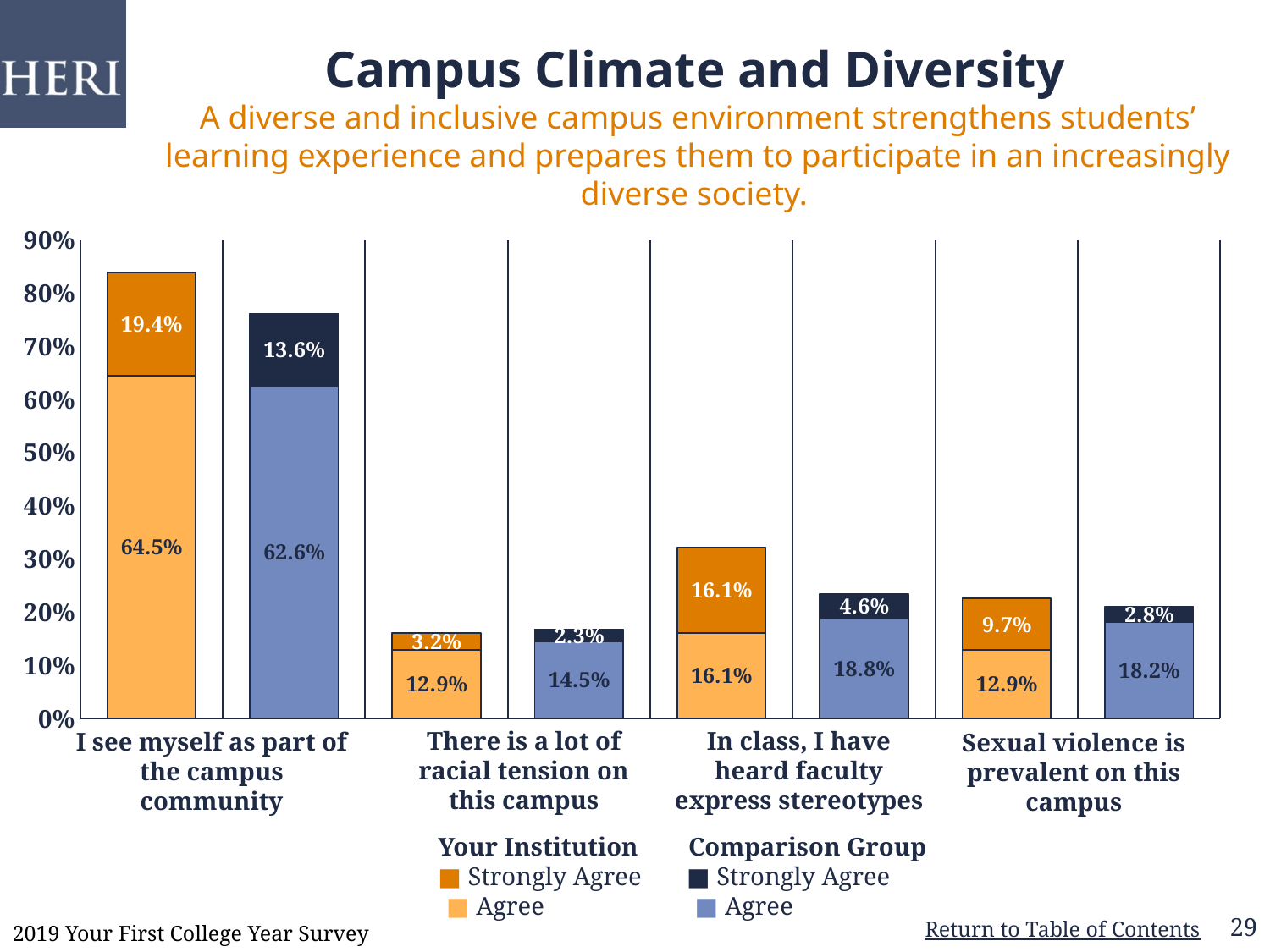
What percentage of the Comparison Group strongly agree that in class they have heard faculty express stereotypes? 4.6% What is the difference between the Your Institution and Comparison Group 'Strongly Agree' values for 'I see myself as part of the campus community'? 5.8% Which statement has the tallest stacked bar for Your Institution? I see myself as part of the campus community What percentage of students at Your Institution strongly agree that they see themselves as part of the campus community? 19.4% Which statement has the shortest stacked bar for the Comparison Group? There is a lot of racial tension on this campus How many series does the legend list? 4 What is the total percentage of the Comparison Group who agree or strongly agree that in class they have heard faculty express stereotypes? 23.4% What kind of chart is shown on the slide? Stacked bar chart What percentage of the Comparison Group agree (not strongly) that they see themselves as part of the campus community? 62.6% What is the total percentage of Your Institution students who agree or strongly agree that they see themselves as part of the campus community? 83.9% What percentage of students at Your Institution agree (not strongly) that sexual violence is prevalent on this campus? 12.9% For 'In class, I have heard faculty express stereotypes', which group has the larger 'Strongly Agree' value, Your Institution or the Comparison Group? Your Institution